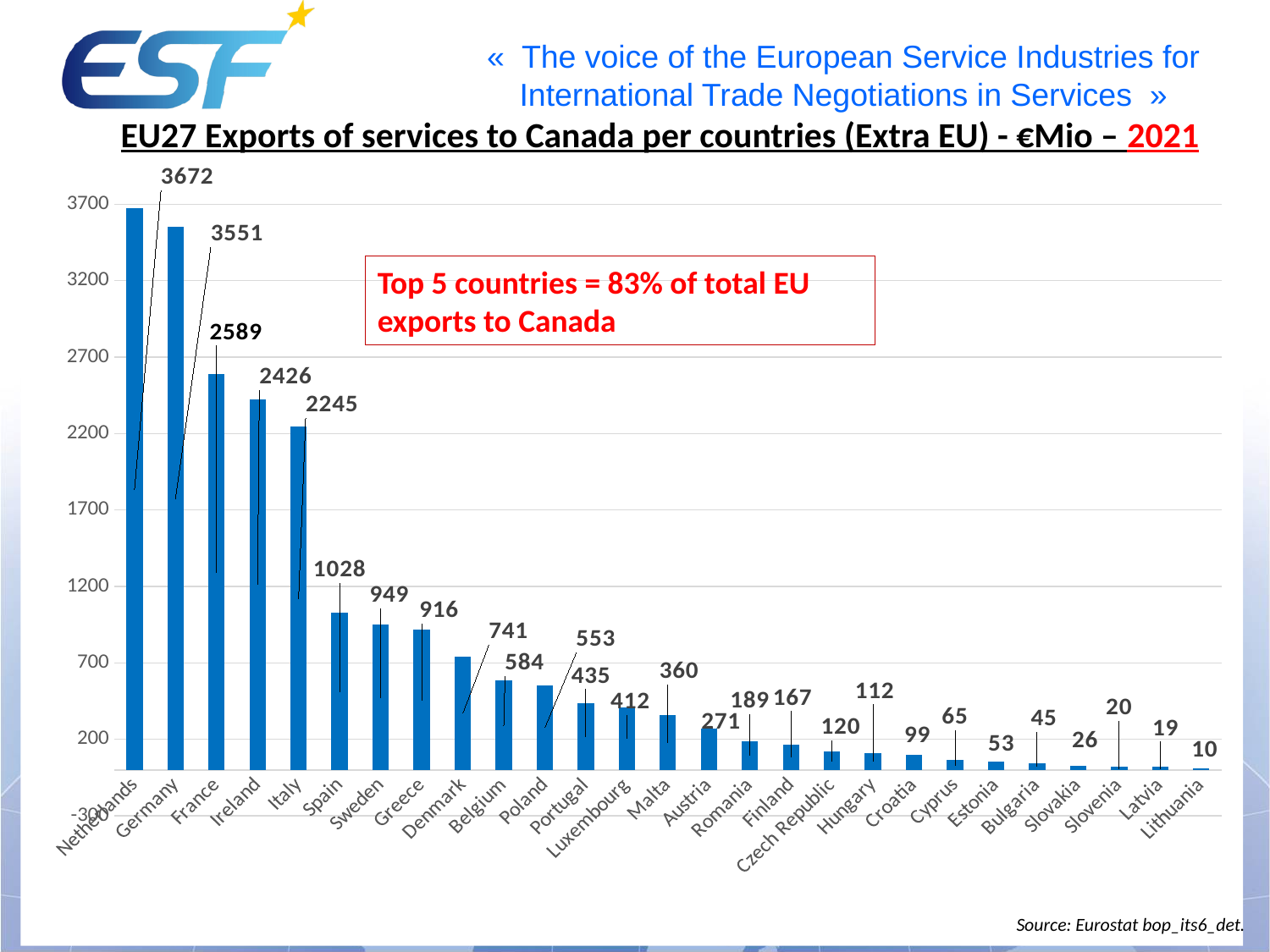
How many countries are shown on the chart? 27 What is the value for the Netherlands? 3672 What kind of chart is shown on the slide? bar chart What is the value for Spain? 1028 Which country has the highest value? Netherlands What is the value for the Czech Republic? 120 What is the value for Malta? 360 Which country has the lowest value? Lithuania What is the difference between the values for the Netherlands and Germany? 121 Do the values rise or fall from left to right along the x axis? fall According to the text box on the chart, what share of total EU exports to Canada do the top 5 countries represent? 83% Which is larger, the value for France or the value for Ireland? France